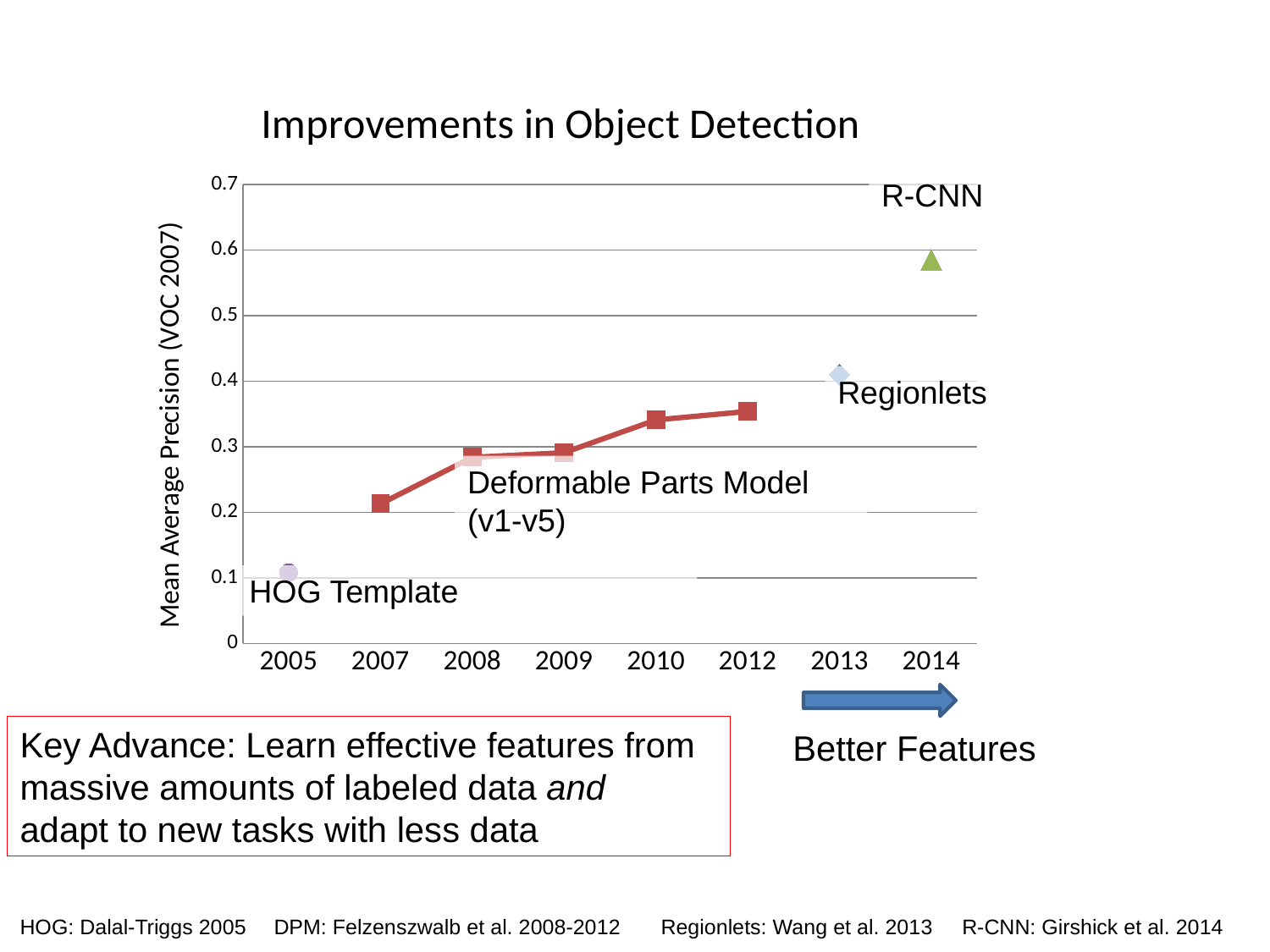
What is the title of the chart? Improvements in Object Detection Is the value for R-CNN (2014) greater or less than 0.5? greater Is the value for the Deformable Parts Model in 2007 greater or less than 0.3? less How many years are shown on the x axis of the chart? 8 Which labeled method has the highest mean average precision in the chart? R-CNN Which labeled method has the lowest mean average precision in the chart? HOG Template What is the label on the vertical axis of the chart? Mean Average Precision (VOC 2007) Is the value for Regionlets (2013) greater or less than 0.5? less Which is larger, the value for Regionlets in 2013 or the value for the Deformable Parts Model in 2012? Regionlets in 2013 Do the mean average precision values generally rise or fall from 2005 to 2014? rise Which year does the R-CNN point appear at on the x axis? 2014